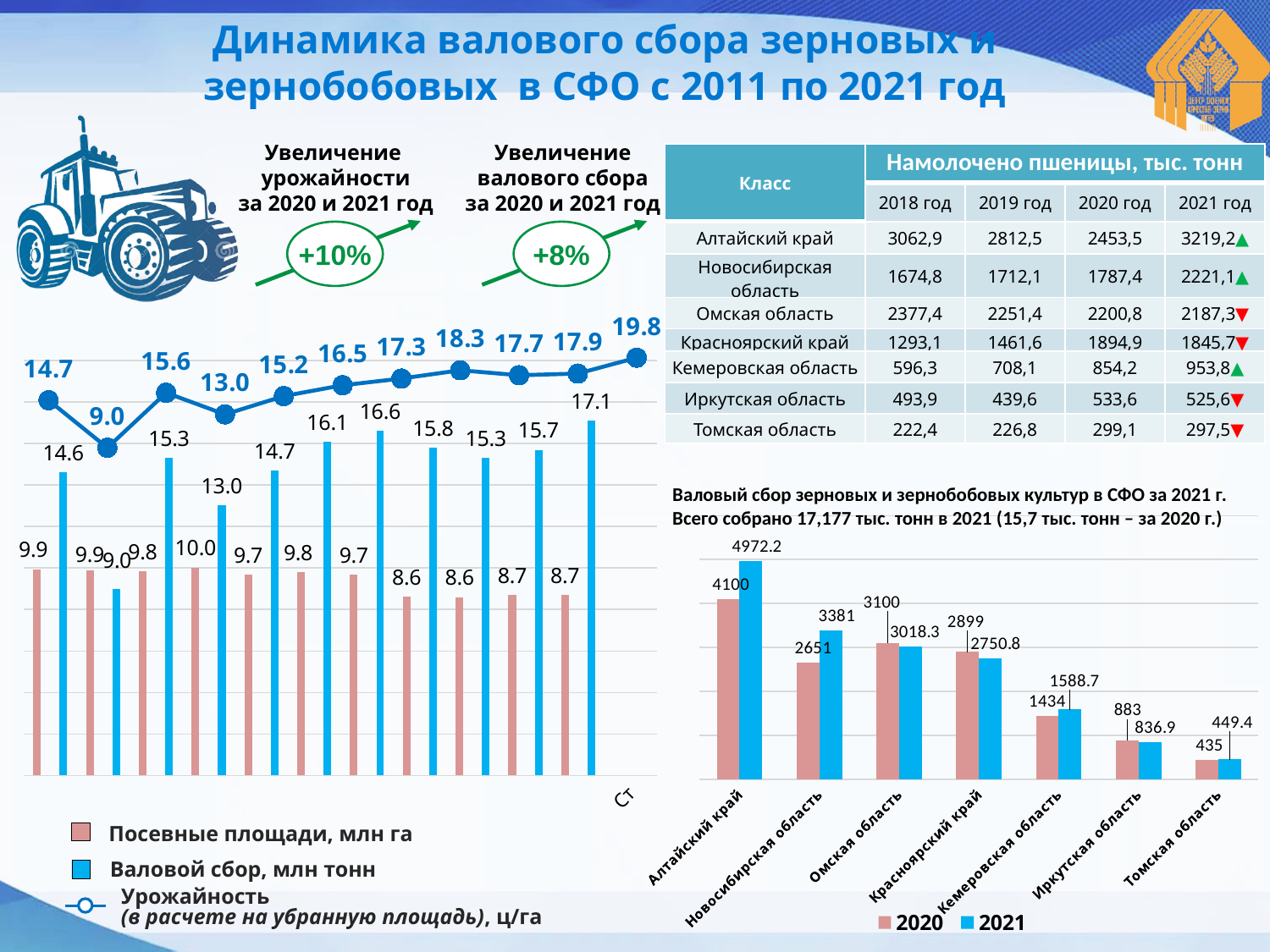
In the bar chart on the right, what is the 2021 value for Кемеровская область? 1588.7 In the bar chart on the right, which region has the highest 2021 value? Алтайский край In the bar chart on the right, which region has the lowest 2020 value? Томская область In the bar chart on the right, what is the 2020 value for Красноярский край? 2899 How many regions are shown in the bar chart on the right? 7 In the bar chart on the right, what is the 2021 value for Новосибирская область? 3381 In the chart on the left, what is the highest value on the Урожайность line? 19.8 In the bar chart on the right, for Омская область, which year has the larger value, 2020 or 2021? 2020 What kind of chart is the chart on the left of the slide? Bar chart with a line How many series does the legend of the bar chart on the right list? 2 How many series does the legend of the chart on the left list? 3 In the bar chart on the right, what is the difference between the 2021 and 2020 values for Алтайский край? 872.2